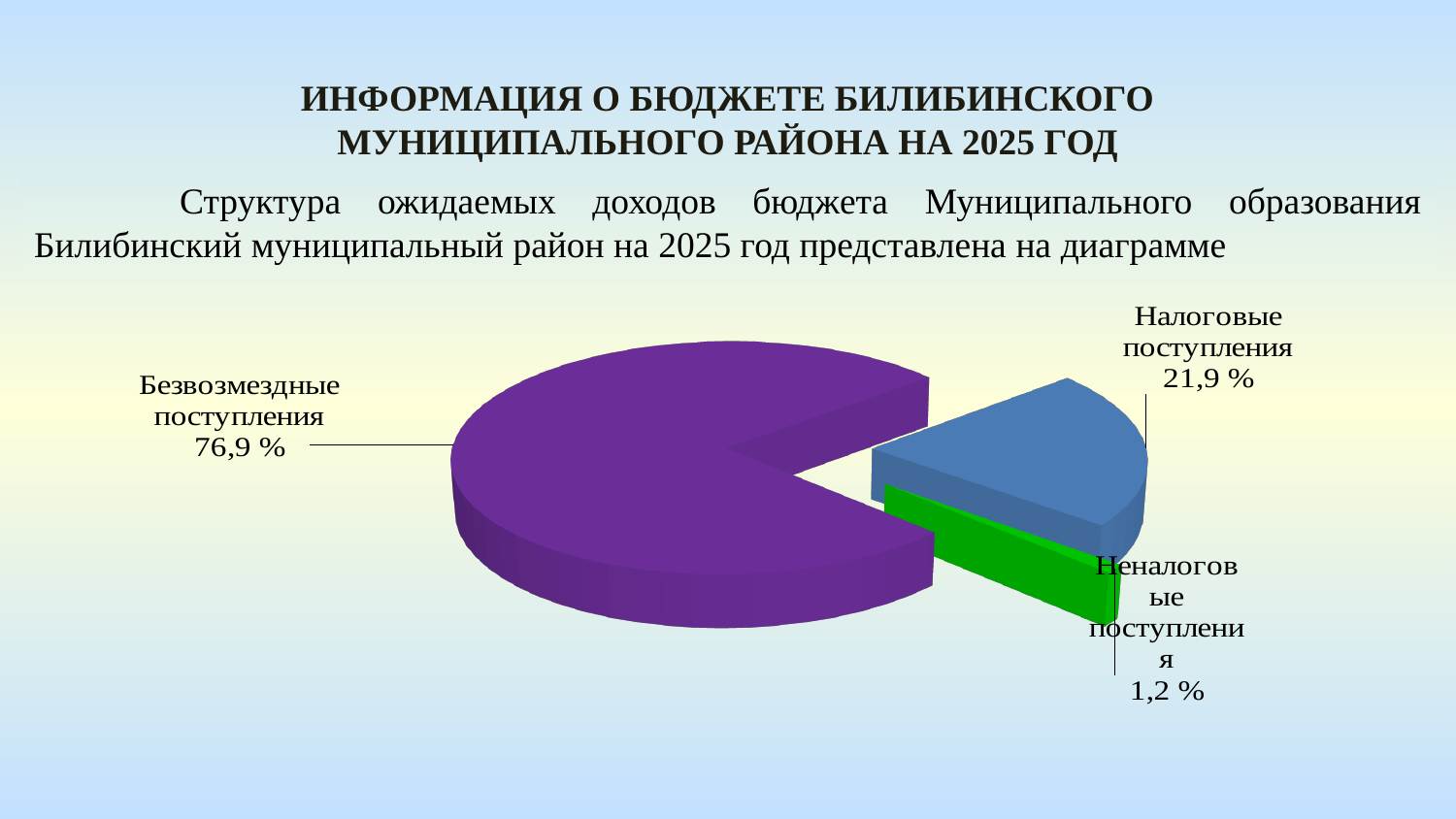
Which category has the largest slice of the pie? Безвозмездные поступления What is the value shown for Налоговые поступления? 21,9 % What colour is the slice for Неналоговые поступления? Green What share of the pie does Безвозмездные поступления account for? 76,9 % What is the difference between the shares of Безвозмездные поступления and Налоговые поступления? 55,0 % Which is larger: the share of Налоговые поступления or the share of Неналоговые поступления? Налоговые поступления What kind of chart is shown on the slide? Pie chart How many categories are shown in the pie chart? 3 What colour is the slice for Безвозмездные поступления? Purple What is the difference between the shares of Налоговые поступления and Неналоговые поступления? 20,7 % What is the value shown for Неналоговые поступления? 1,2 % Which category has the smallest slice of the pie? Неналоговые поступления